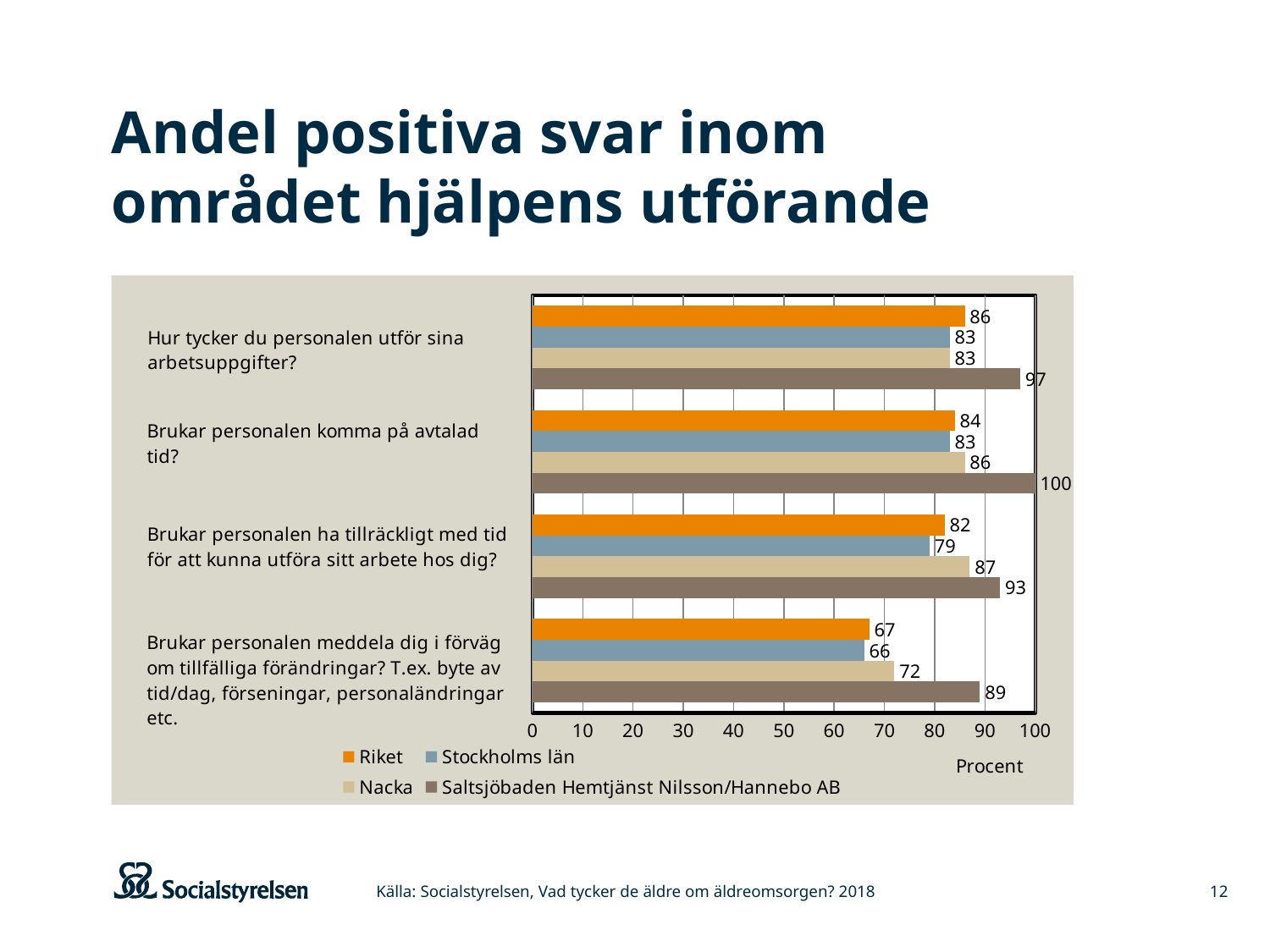
How many question categories are plotted on the chart? 4 What is the value for Saltsjöbaden Hemtjänst Nilsson/Hannebo AB for "Brukar personalen komma på avtalad tid?" 100 What is the value for Nacka for "Brukar personalen ha tillräckligt med tid för att kunna utföra sitt arbete hos dig?" 87 What is the value for Riket for "Hur tycker du personalen utför sina arbetsuppgifter?" 86 What is the value for Stockholms län for "Brukar personalen meddela dig i förväg om tillfälliga förändringar?" 66 How many series does the legend list? 4 What label is shown on the horizontal axis of the chart? Procent Which series has the lowest value for "Brukar personalen ha tillräckligt med tid för att kunna utföra sitt arbete hos dig?" Stockholms län For "Brukar personalen komma på avtalad tid?", which is larger: the value for Nacka or the value for Riket? Nacka What is the difference between Saltsjöbaden Hemtjänst Nilsson/Hannebo AB and Riket for "Brukar personalen meddela dig i förväg om tillfälliga förändringar?" 22 Which series has the highest value for "Brukar personalen meddela dig i förväg om tillfälliga förändringar?" Saltsjöbaden Hemtjänst Nilsson/Hannebo AB What kind of chart is shown on the slide? Bar chart